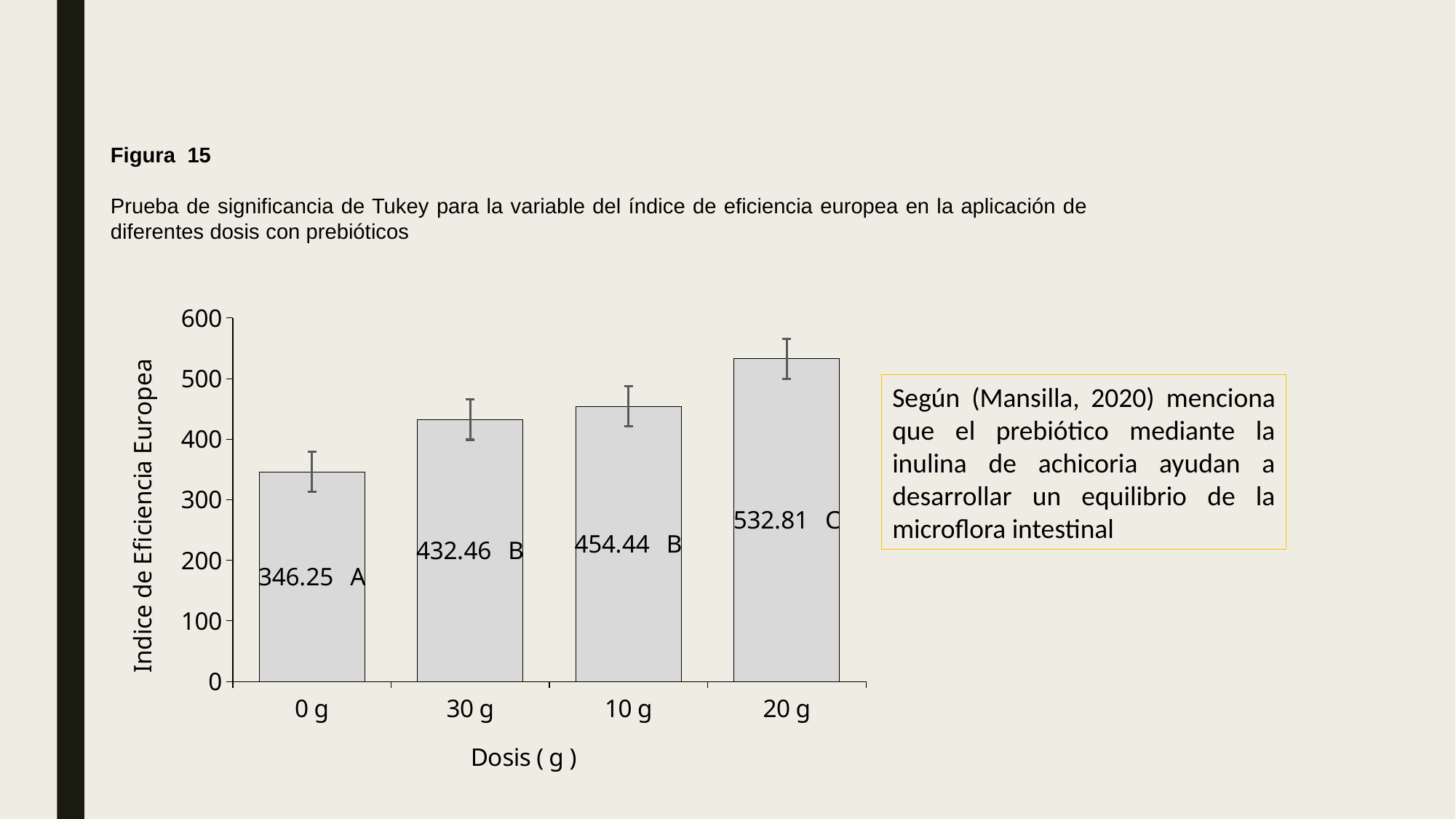
What is the value of the bar for the 20 g dose? 532.81 What is the value of the bar for the 10 g dose? 454.44 What kind of chart is shown on the slide? bar chart Which Tukey significance letter is assigned to the 20 g dose? C What is the value of the bar for the 0 g dose? 346.25 What is the difference between the values for the 20 g and 0 g doses? 186.56 Is the value for the 20 g dose greater or less than 500? greater Which dose has the lowest Indice de Eficiencia Europea? 0 g How many dose categories are shown on the x axis? 4 Which dose has the highest Indice de Eficiencia Europea? 20 g Which is larger, the value for 30 g or the value for 10 g? 10 g What is the difference between the values for the 10 g and 30 g doses? 21.98